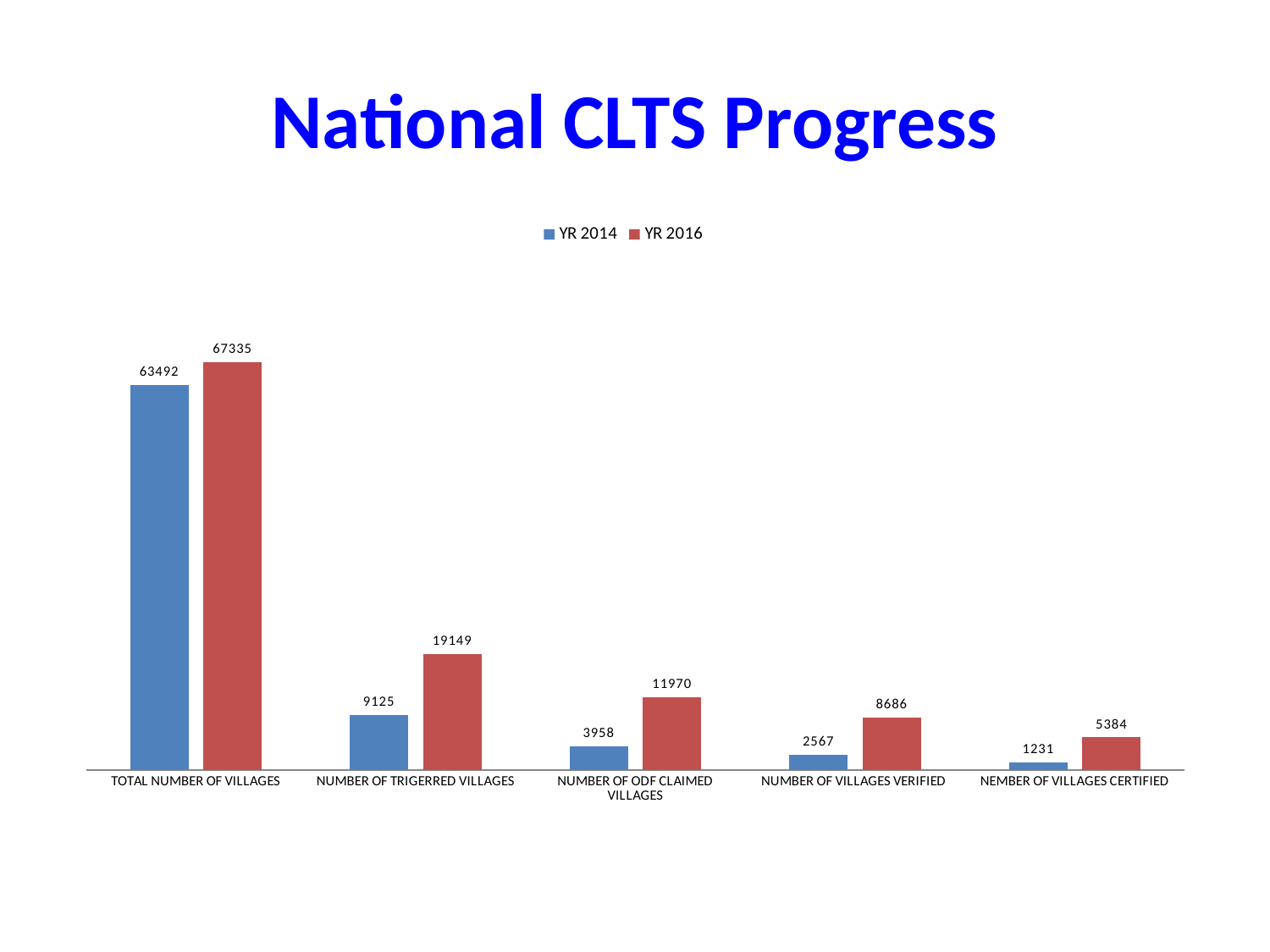
Which category has the lowest YR 2014 value? NEMBER OF VILLAGES CERTIFIED What kind of chart is shown on the slide? Bar chart What is the difference between the YR 2016 and YR 2014 values for NUMBER OF VILLAGES VERIFIED? 6119 How many categories are shown on the x axis? 5 What is the difference between the YR 2016 and YR 2014 values for NUMBER OF TRIGERRED VILLAGES? 10024 Which is larger: the YR 2014 value for NUMBER OF TRIGERRED VILLAGES or the YR 2016 value for NUMBER OF VILLAGES VERIFIED? YR 2014 value for NUMBER OF TRIGERRED VILLAGES How many series does the legend list? 2 What is the YR 2016 value for NEMBER OF VILLAGES CERTIFIED? 5384 What is the title of the chart? National CLTS Progress What is the YR 2014 value for NUMBER OF ODF CLAIMED VILLAGES? 3958 What is the YR 2016 value for TOTAL NUMBER OF VILLAGES? 67335 Which category has the highest YR 2016 value? TOTAL NUMBER OF VILLAGES